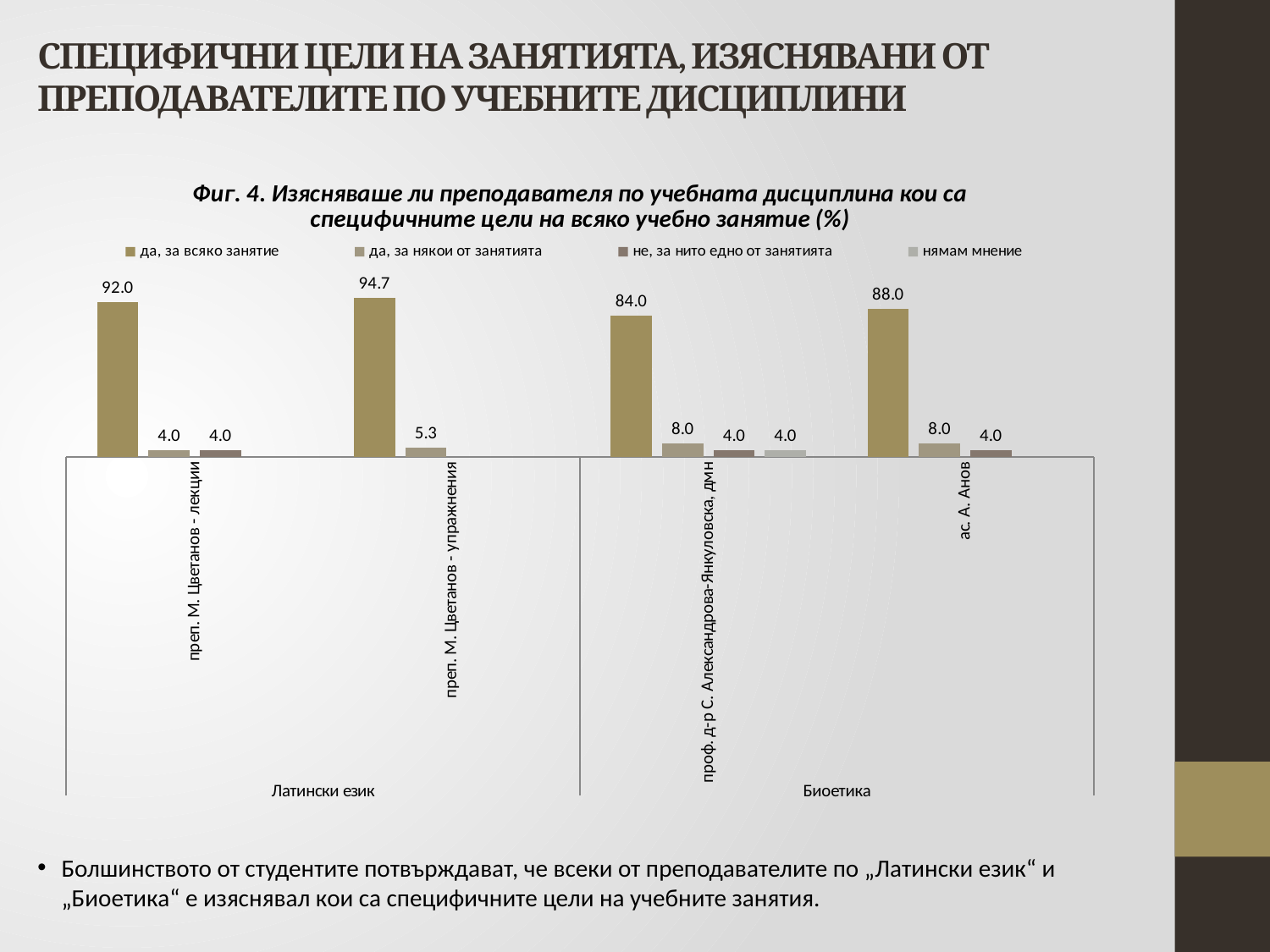
Which two subjects are the categories grouped under on the x axis? Латински език and Биоетика Which category has the lowest value for "да, за всяко занятие"? проф. д-р С. Александрова-Янкуловска, дмн How many series does the legend list? 4 What kind of chart is shown on the slide? bar chart How many categories (teachers) are shown on the x axis? 4 What is the value of "да, за някои от занятията" for "проф. д-р С. Александрова-Янкуловска, дмн"? 8.0 Which is larger: the "да, за всяко занятие" value for "преп. М. Цветанов - лекции" or for "ас. А. Анов"? преп. М. Цветанов - лекции What is the difference between the "да, за всяко занятие" values for "преп. М. Цветанов - упражнения" and "проф. д-р С. Александрова-Янкуловска, дмн"? 10.7 What is the value of "да, за всяко занятие" for "ас. А. Анов"? 88.0 What is the value of "да, за всяко занятие" for "преп. М. Цветанов - лекции"? 92.0 What is the value of "да, за всяко занятие" for "преп. М. Цветанов - упражнения"? 94.7 Which category has the highest value for "да, за всяко занятие"? преп. М. Цветанов - упражнения